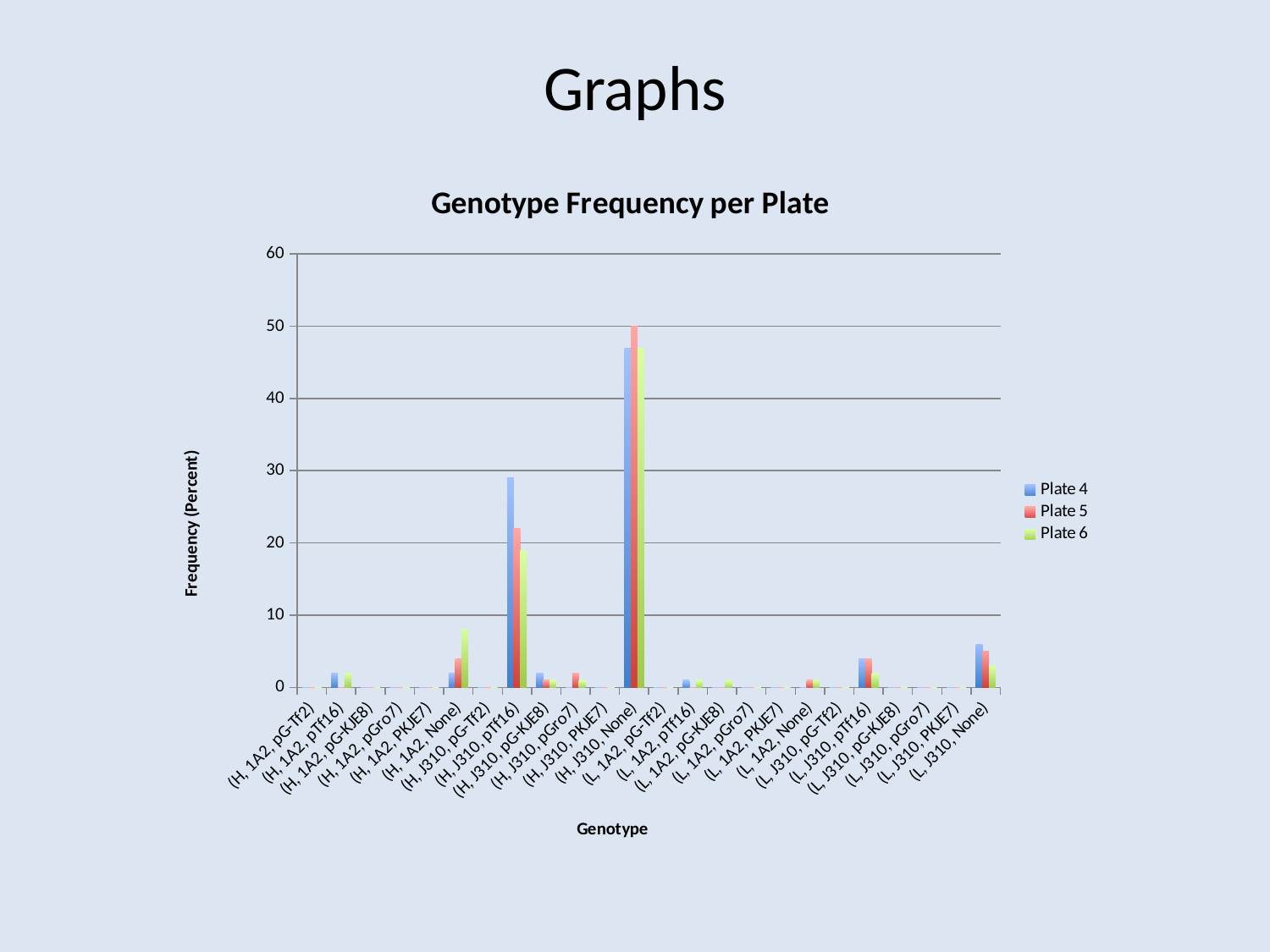
Is the Plate 4 value for (H, J310, pTf16) greater or less than 20? greater Which series has the tallest bar at (H, J310, None)? Plate 5 What type of chart is shown on the slide? Bar chart What is the label of the vertical axis? Frequency (Percent) At (H, 1A2, None), which is larger: the Plate 4 value or the Plate 6 value? Plate 6 At (H, J310, pTf16), which is larger: the Plate 4 value or the Plate 6 value? Plate 4 Is the Plate 4 value for (H, J310, None) greater or less than 40? greater What is the title of the chart? Genotype Frequency per Plate Which genotype has the highest frequency for Plate 4? (H, J310, None) How many series does the legend list? 3 How many genotype categories are shown on the x axis? 24